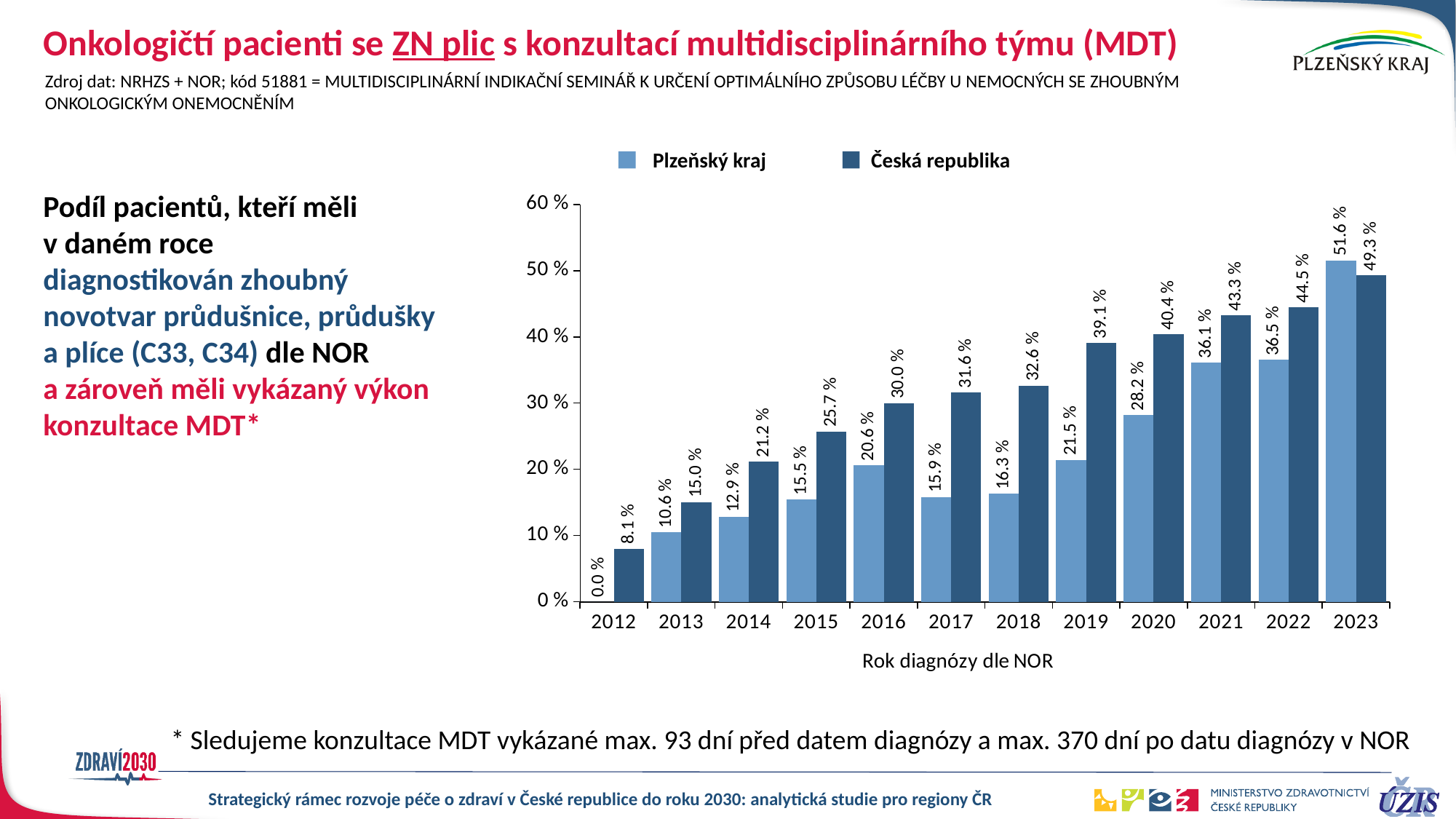
In which year is the value for Plzeňský kraj lowest? 2012 What is the value for Plzeňský kraj in 2020? 28.2 % Is the value for Česká republika in 2021 greater or less than 40 %? greater What is the value for Česká republika in 2016? 30.0 % How many series does the legend list? 2 How many years are shown on the x axis? 12 What is the label of the x axis? Rok diagnózy dle NOR What is the difference between Česká republika and Plzeňský kraj in 2019? 17.6 % In which year is the value for Česká republika highest? 2023 What kind of chart is shown on the slide? bar chart What is the value for Plzeňský kraj in 2012? 0.0 % In 2023, which series has the larger value, Plzeňský kraj or Česká republika? Plzeňský kraj